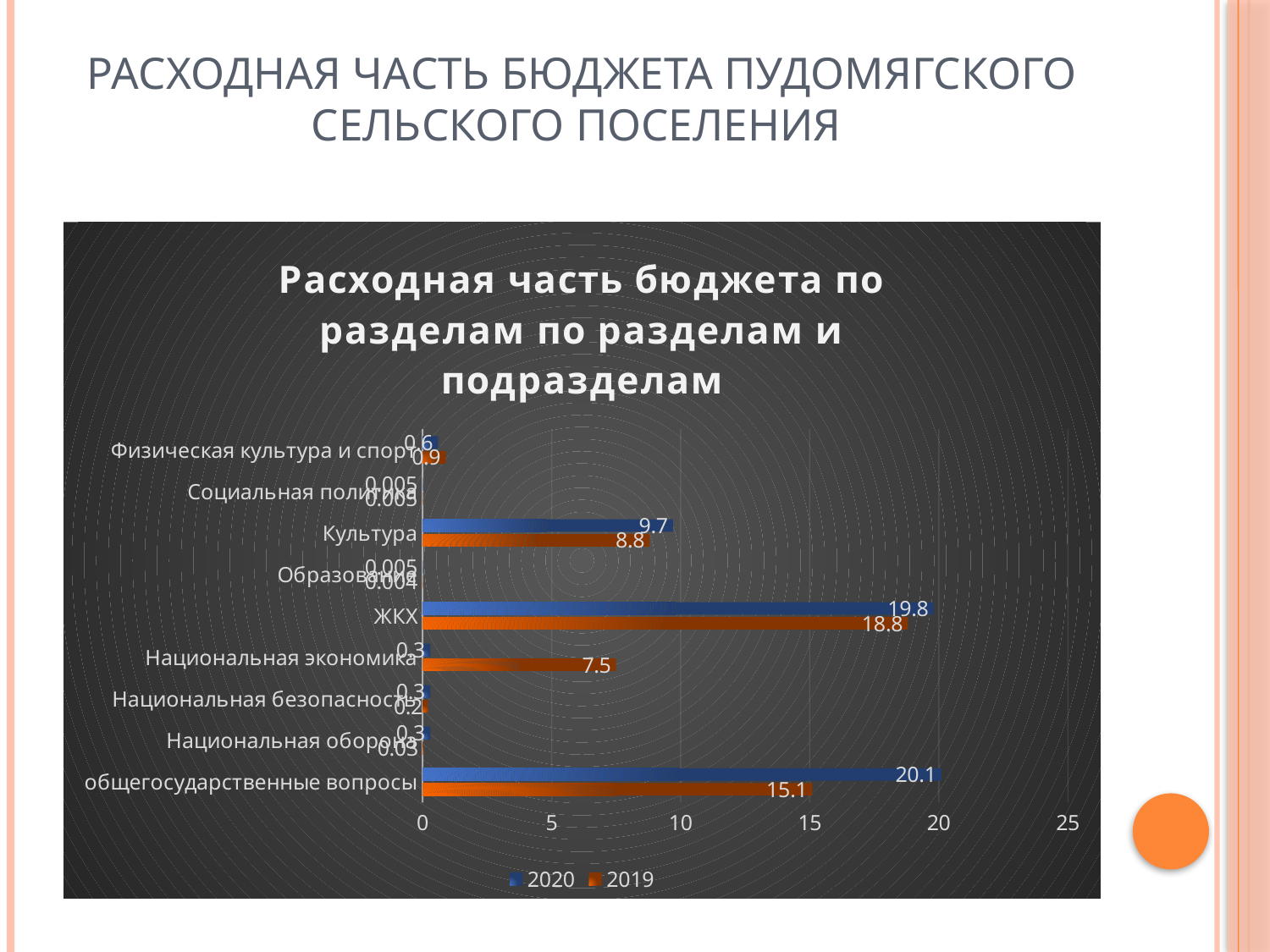
Is the 2019 value for Культура greater or less than 10? less What is the 2020 value for Культура? 9.7 What is the difference between the 2020 and 2019 values for общегосударственные вопросы? 5 What is the 2020 value for ЖКХ? 19.8 Which category has the highest 2020 value? общегосударственные вопросы What is the 2019 value for ЖКХ? 18.8 How many series does the legend list? 2 For Национальная экономика, which year has the larger value, 2019 or 2020? 2019 What kind of chart is shown on the slide? bar chart What is the 2019 value for общегосударственные вопросы? 15.1 What is the difference between the 2020 and 2019 values for ЖКХ? 1 How many categories are plotted on the chart? 9